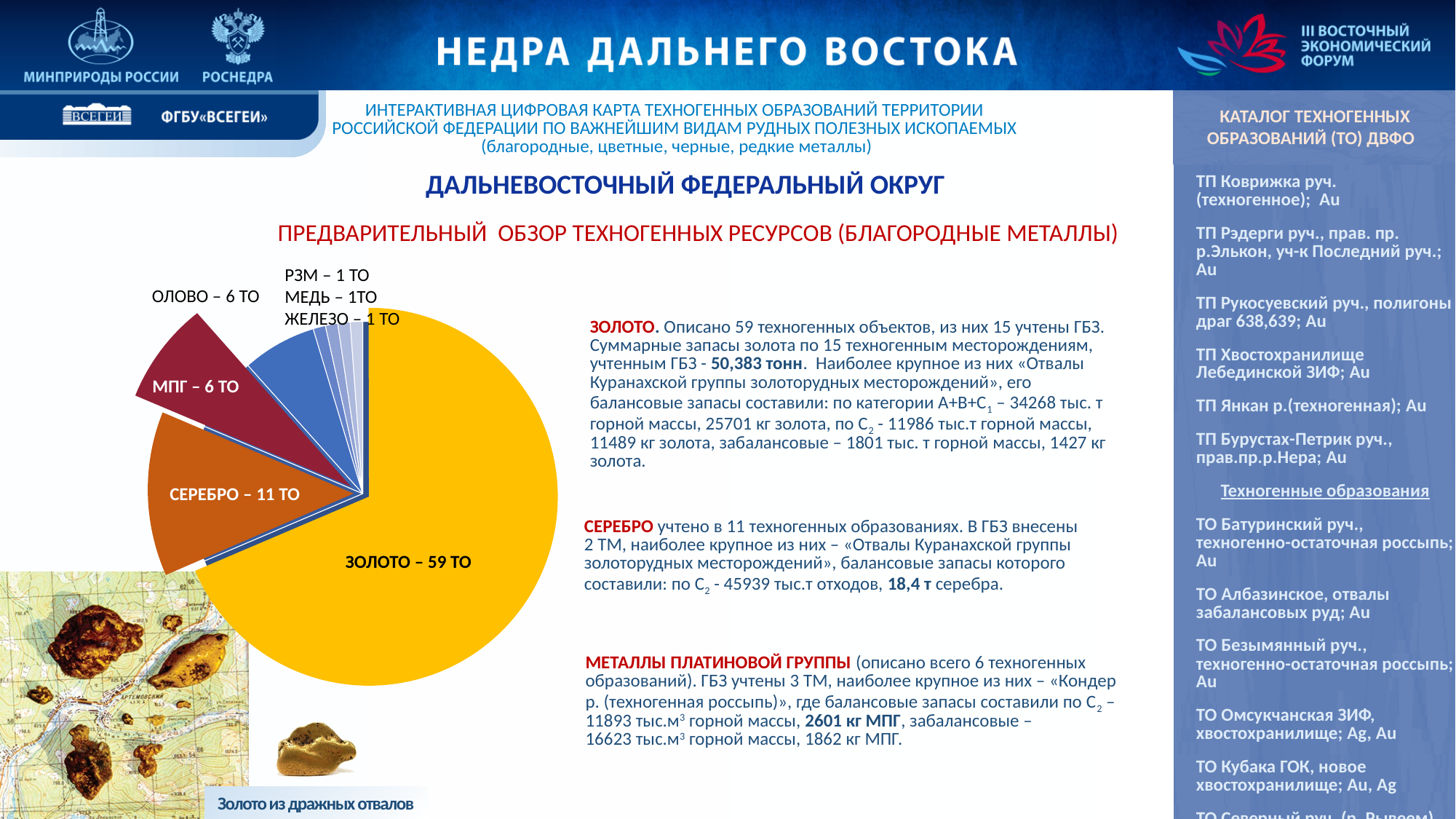
How many categories (slices) does the pie chart show? 8 How many technogenic objects (ТО) does the pie chart show for ЗОЛОТО? 59 ТО What value does the pie chart give for СЕРЕБРО? 11 ТО Which is larger in the pie chart, the value for СЕРЕБРО or the value for МПГ? СЕРЕБРО What value does the pie chart give for МПГ? 6 ТО What is the red heading printed above the pie chart? ПРЕДВАРИТЕЛЬНЫЙ ОБЗОР ТЕХНОГЕННЫХ РЕСУРСОВ (БЛАГОРОДНЫЕ МЕТАЛЛЫ) What type of chart is shown on the slide? pie chart What value does the pie chart give for МЕДЬ? 1 ТО Which category has the largest slice in the pie chart? ЗОЛОТО What value does the pie chart give for ОЛОВО? 6 ТО What is the difference between the values for ЗОЛОТО and СЕРЕБРО in the pie chart? 48 ТО